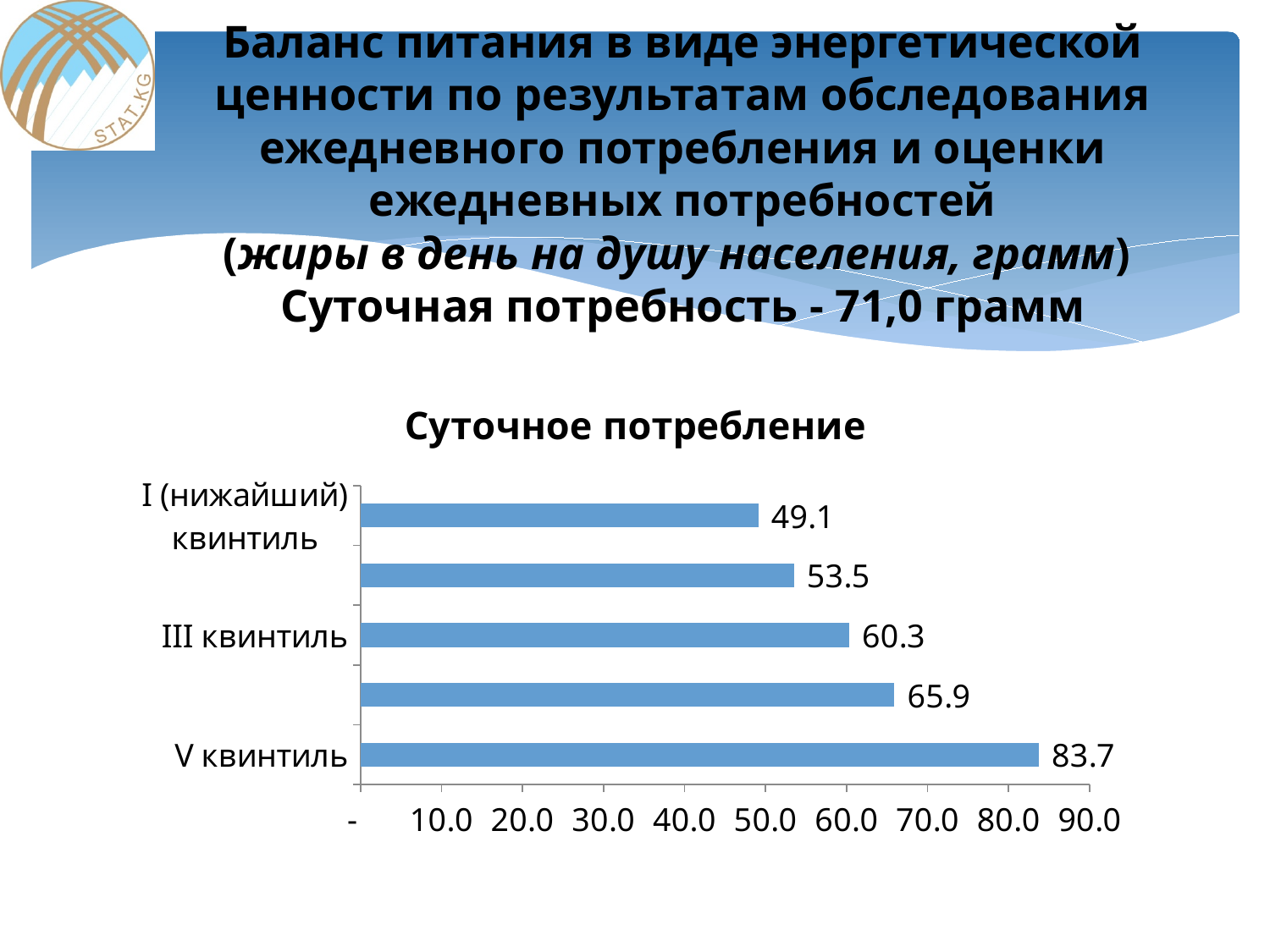
What is the value for III квинтиль? 60.3 What is the value for V квинтиль? 83.7 Which category has the highest value? V квинтиль What is the title of the chart? Суточное потребление Which category has the lowest value? I (нижайший) квинтиль How many bars are shown in the chart? 5 Is the value for V квинтиль greater or less than 80.0? greater What kind of chart is shown on the slide? bar chart What is the difference between the values for III квинтиль and I (нижайший) квинтиль? 11.2 Which is larger, the value for III квинтиль or the value for V квинтиль? V квинтиль What is the difference between the values for V квинтиль and I (нижайший) квинтиль? 34.6 What is the value for I (нижайший) квинтиль? 49.1